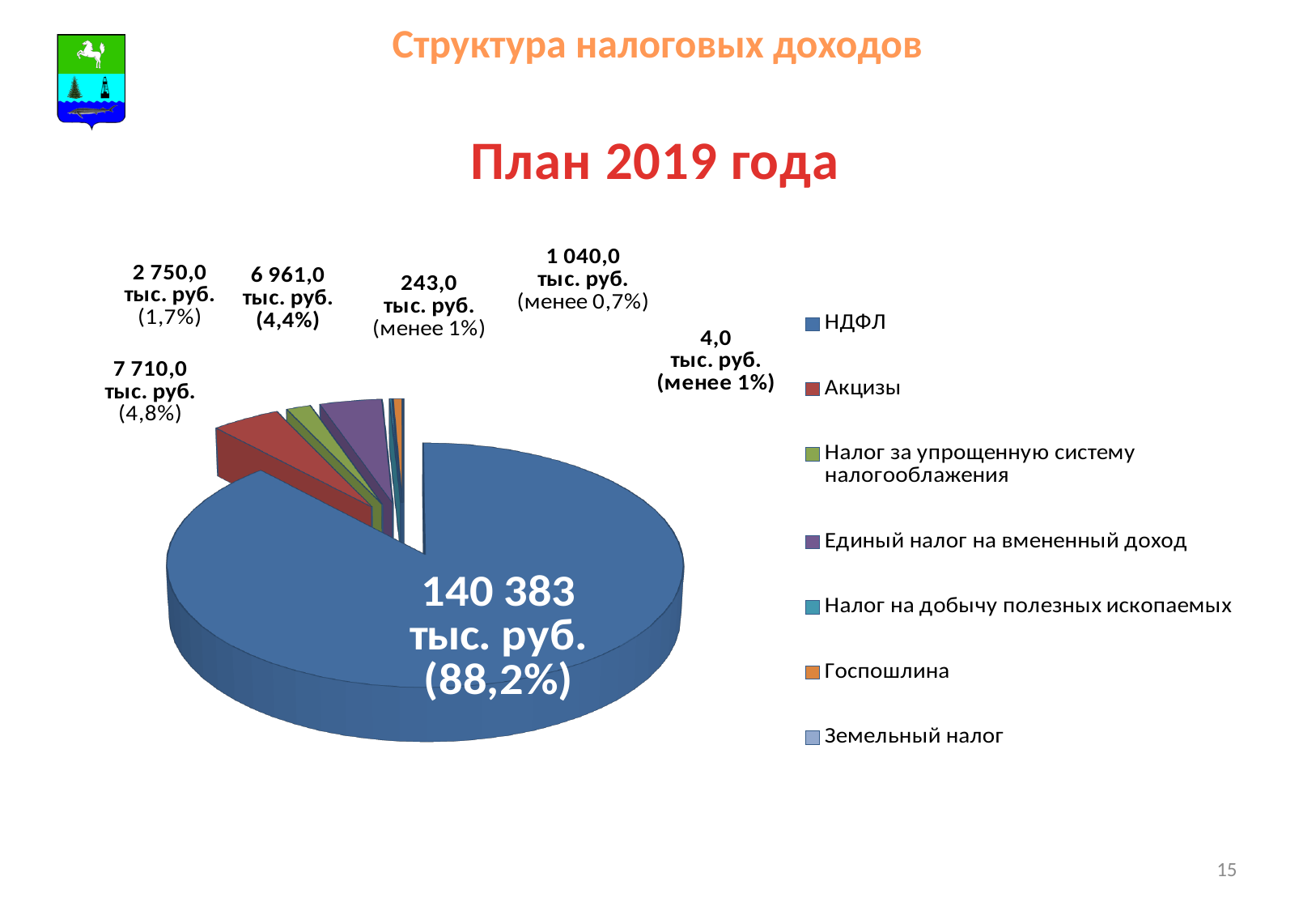
What kind of chart is shown on the slide? pie chart How many entries does the legend of the pie chart list? 7 What share of the pie does НДФЛ account for? 88,2% Which is larger: the slice for НДФЛ or the slice for Акцизы? НДФЛ How many slices does the pie chart have? 7 What colour is the slice for НДФЛ in the pie chart? blue What value is shown for НДФЛ in the pie chart? 140 383 тыс. руб. What is the largest value labelled on the pie chart? 140 383 тыс. руб. What is the smallest value labelled on the pie chart? 4,0 тыс. руб. Which category has the largest slice in the pie chart? НДФЛ